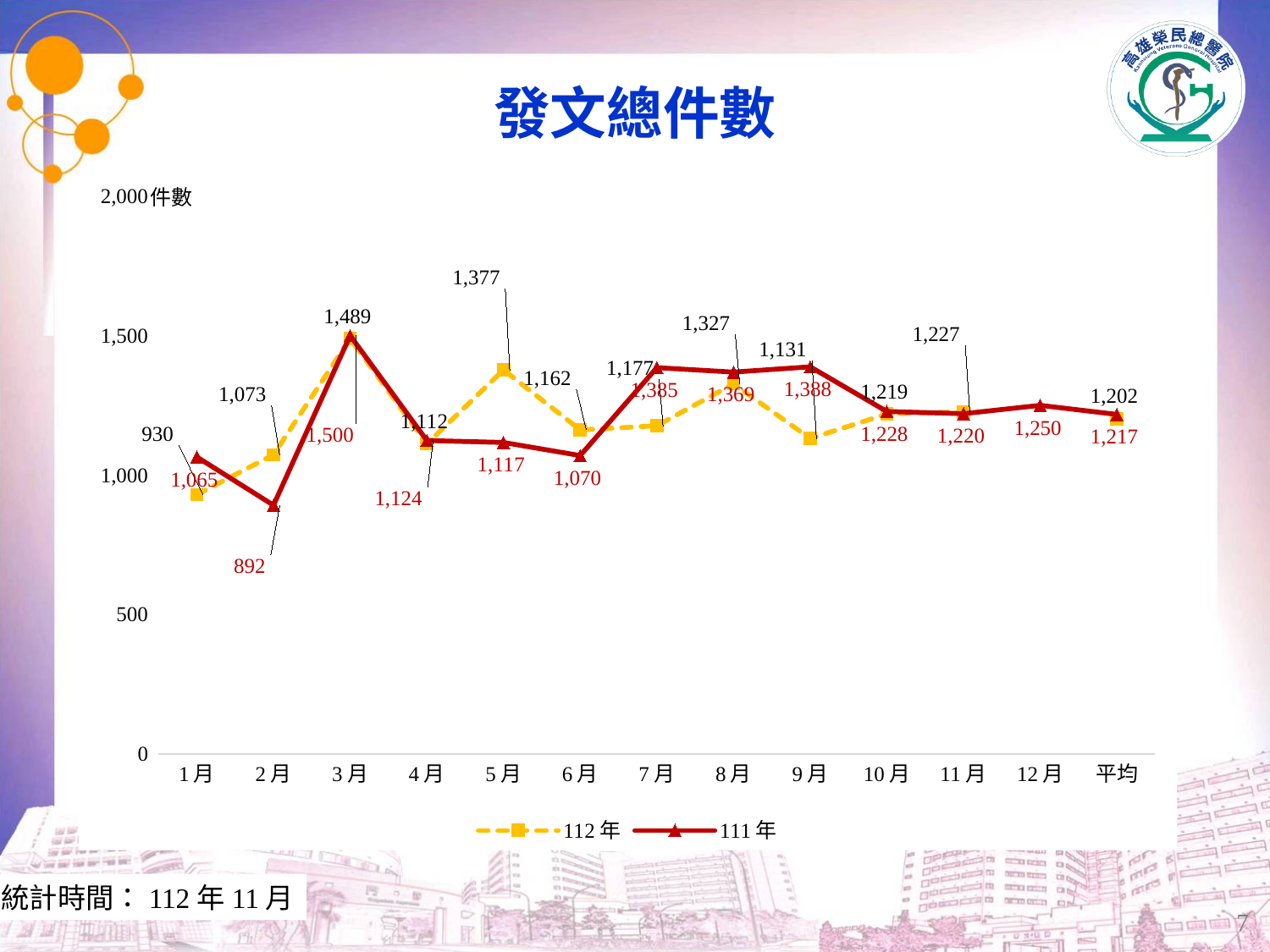
What is the 平均 value for the 112年 series? 1,202 In which month does the 112年 series have its lowest value? 1月 What is the value for 112年 in 5月? 1,377 In which month does the 111年 series reach its highest value? 3月 What kind of chart is shown on the slide? line chart What is the difference between the 111年 and 112年 values in 3月? 11 How many categories are shown on the x axis? 13 What is the value for 111年 in 2月? 892 In 9月, which series has the larger value, 112年 or 111年? 111年 How many series does the legend list? 2 Is the value for 111年 in 2月 greater or less than 1,000? less What is the difference between the 112年 and 111年 values in 5月? 260